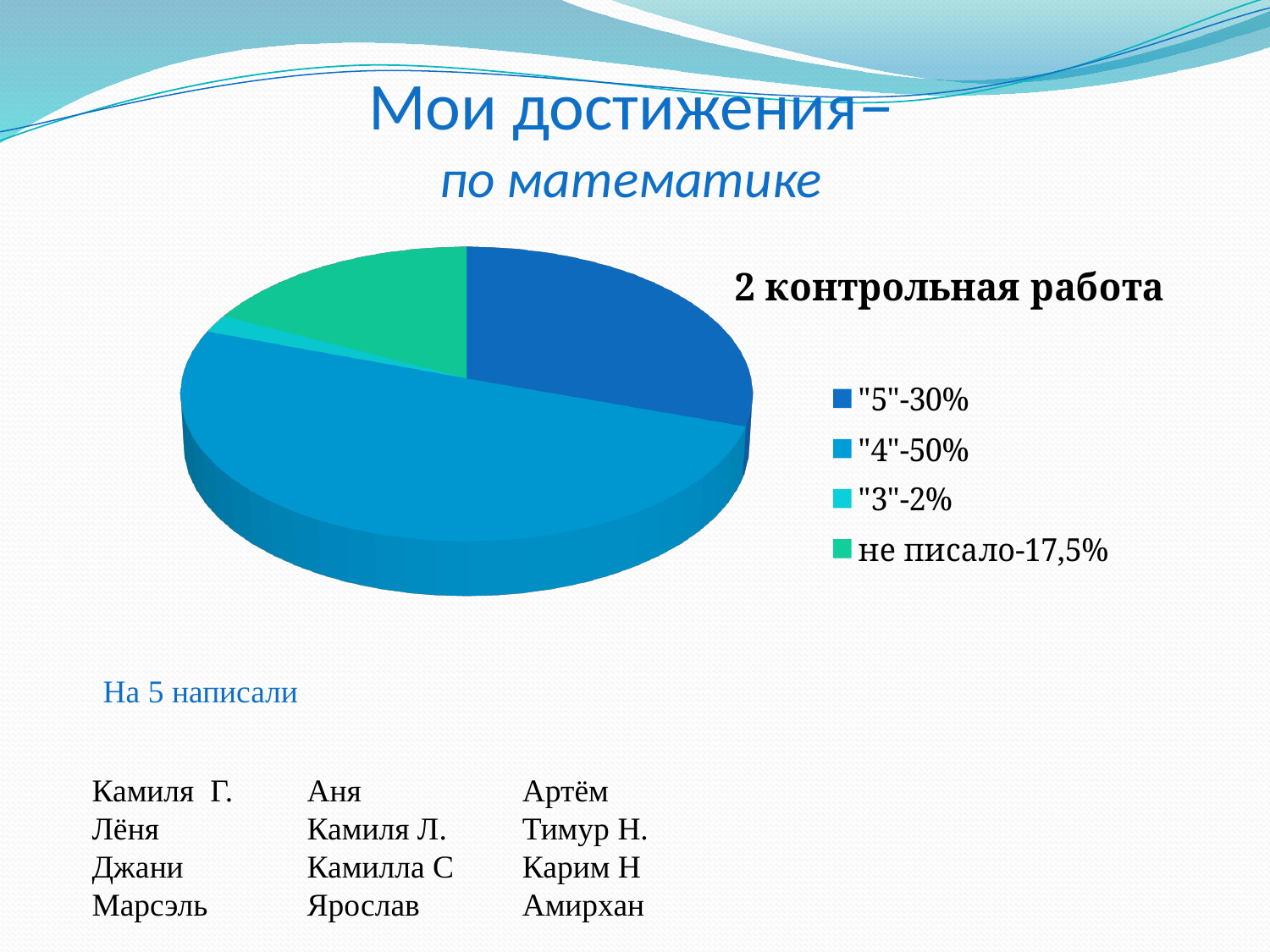
What is the title of the chart? 2 контрольная работа Which legend category has the largest slice of the pie? "4"-50% What share of the pie corresponds to the grade "3"? 2% What is the difference in percentage points between the share for grade "4" and the share for grade "5"? 20% How many slices does the pie chart have? 4 What kind of chart is shown on the slide? pie chart How many entries does the chart legend list? 4 Which slice is larger: the one for grade "5" or the one for "не писало"? grade "5" What share of the pie corresponds to the grade "4"? 50% What share of the pie corresponds to the grade "5"? 30% Which legend category has the smallest slice of the pie? "3"-2%